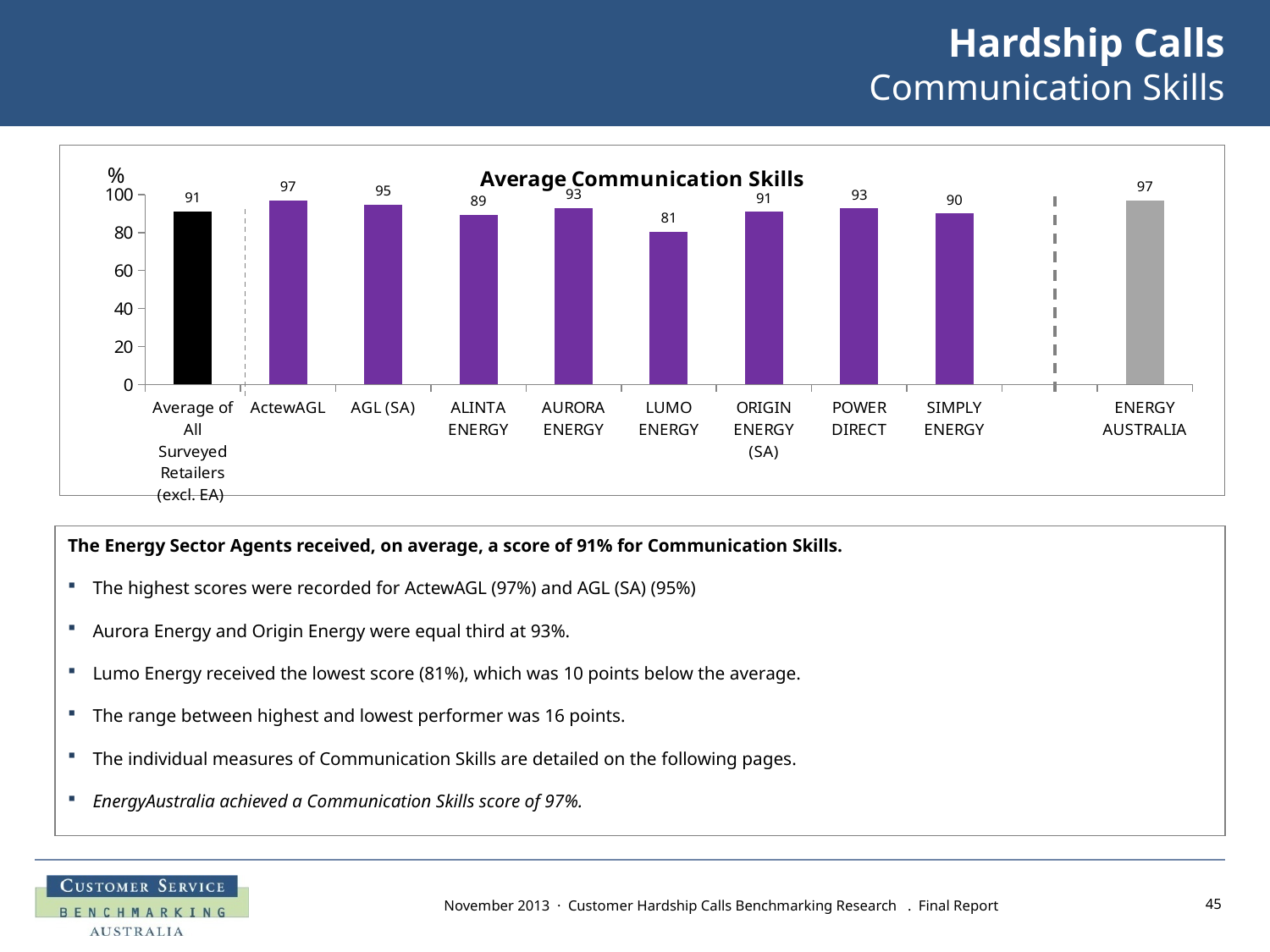
What is the title of the chart? Average Communication Skills How many bars are plotted in the chart? 10 What is the value for AGL (SA)? 95 What is the difference between the values for ActewAGL and LUMO ENERGY? 16 What is the value for the Average of All Surveyed Retailers (excl. EA)? 91 What kind of chart is shown on the slide? bar chart Which is larger, the value for POWER DIRECT or the value for SIMPLY ENERGY? POWER DIRECT Is the value for LUMO ENERGY greater or less than 90? less What is the value for SIMPLY ENERGY? 90 Which category has the lowest value? LUMO ENERGY What is the difference between the values for AGL (SA) and ALINTA ENERGY? 6 What is the value for LUMO ENERGY? 81